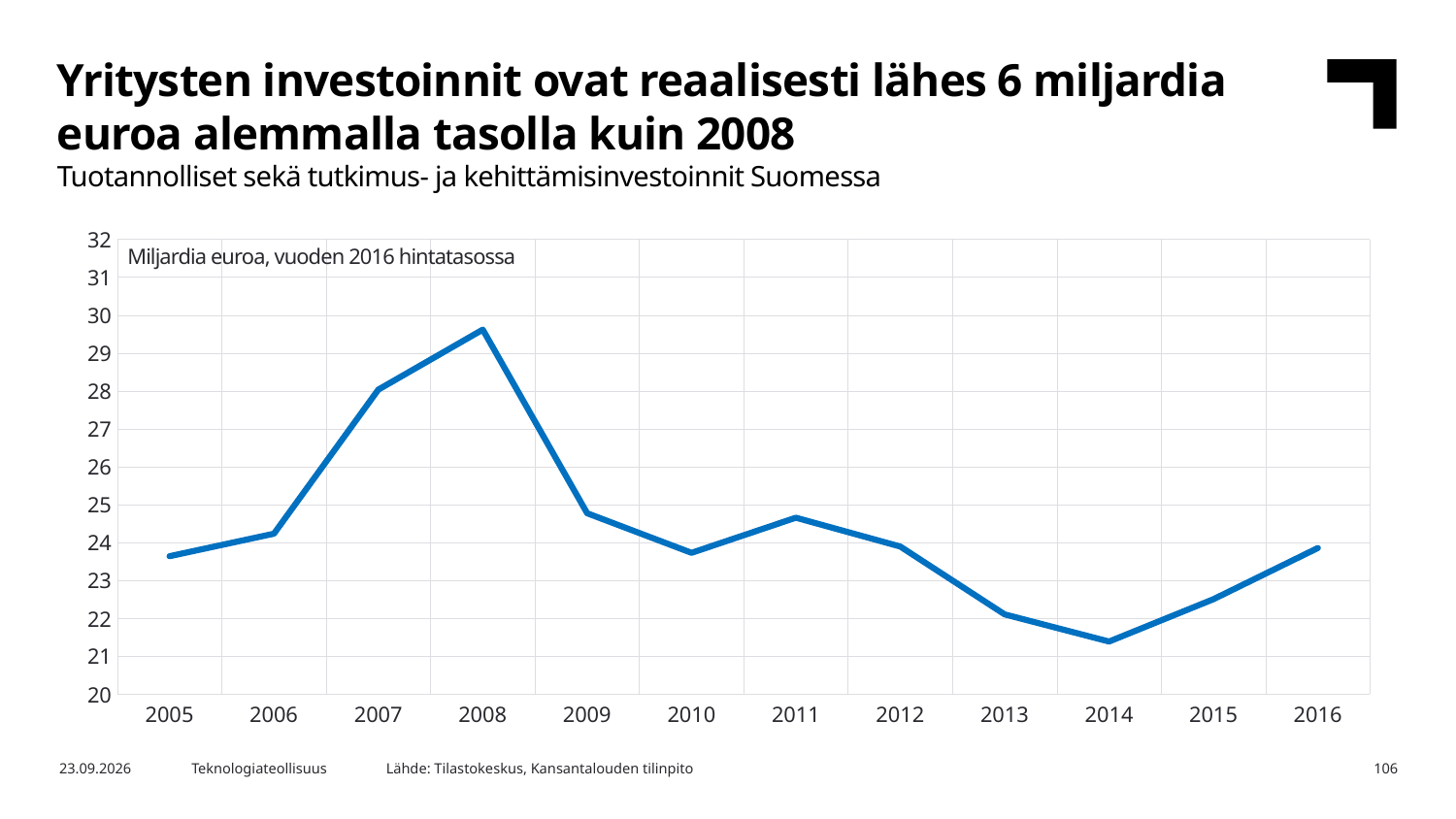
In which year does the line reach its highest value? 2008 Do the values rise or fall between 2008 and 2010? fall Is the value for 2007 greater or less than 27? greater Is the value for 2013 greater or less than 23? less What unit is stated in the label inside the chart area? Miljardia euroa, vuoden 2016 hintatasossa Is the value for 2008 greater or less than 29? greater How many years are plotted on the x axis of the chart? 12 Which year has the larger value, 2007 or 2011? 2007 Which year has the larger value, 2009 or 2013? 2009 What kind of chart is shown on the slide? line chart In which year does the line reach its lowest value? 2014